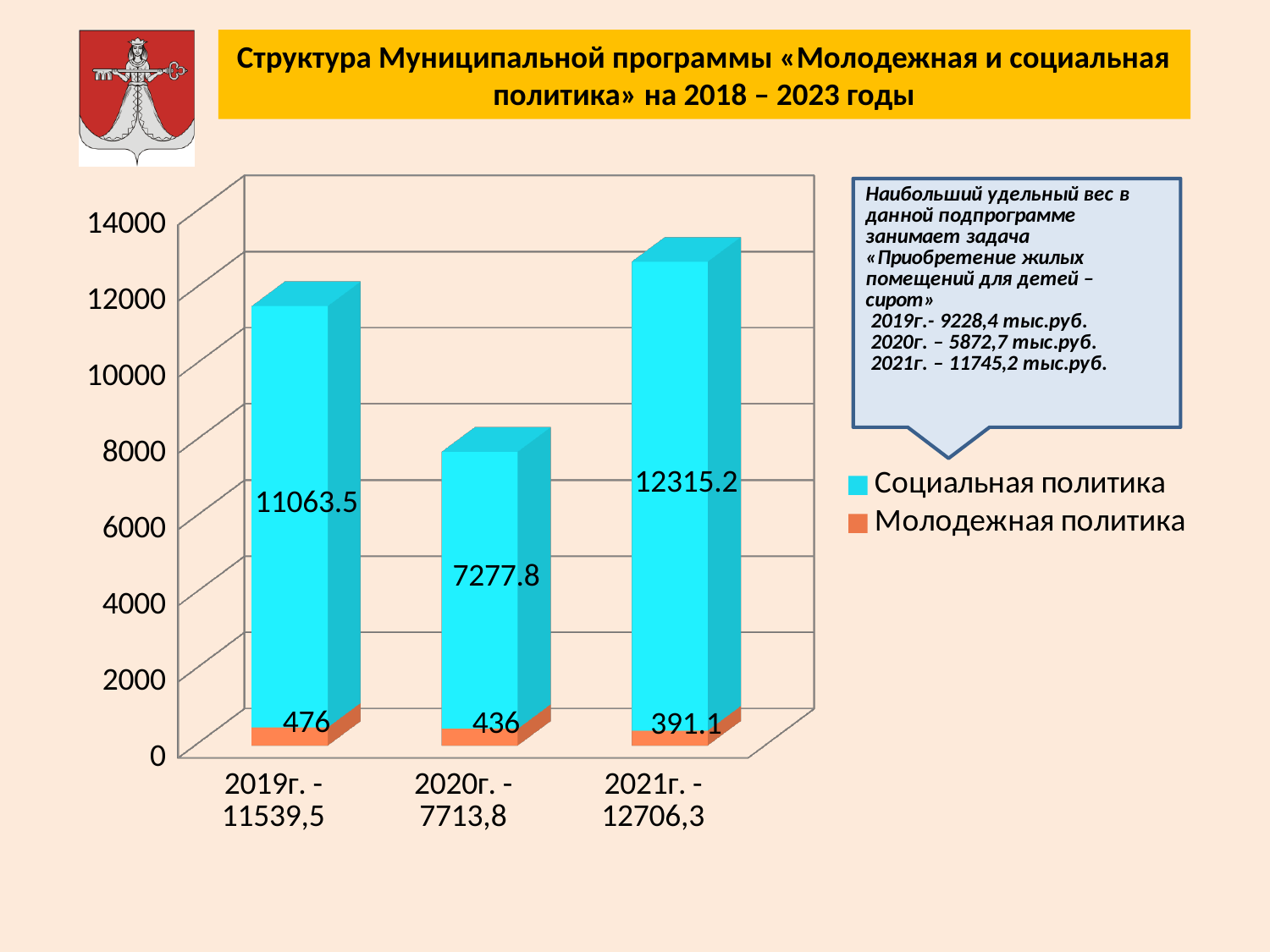
What kind of chart is shown on the slide? Stacked bar chart What is the value for Социальная политика in 2021? 12315.2 What is the value for Молодежная политика in 2021? 391.1 What is the difference between the Социальная политика values for 2021 and 2020? 5037.4 What is the value for Молодежная политика in 2020? 436 Which year has the highest value for Социальная политика? 2021 How many series does the legend list? 2 What is the total of the stacked bar for 2020? 7713.8 How many years are shown on the x axis? 3 What is the value for Социальная политика in 2019? 11063.5 Which year has the lowest value for Молодежная политика? 2021 Which is larger: Молодежная политика in 2019 or in 2020? 2019